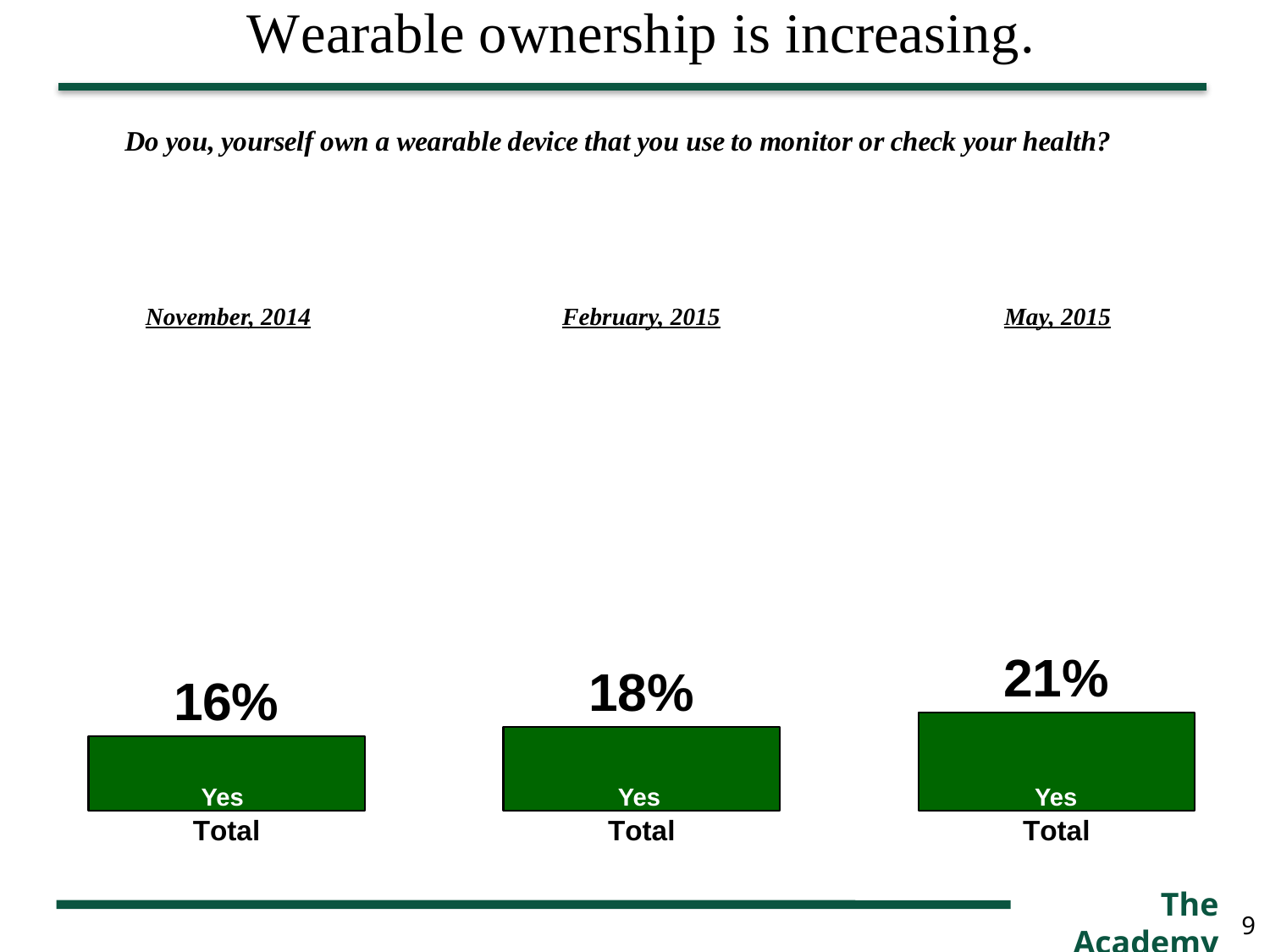
Across the three charts, which date shows the highest Yes percentage? May, 2015 What kind of chart is the November, 2014 chart? Bar chart Across the three charts, which date shows the lowest Yes percentage? November, 2014 What is the difference between the Yes percentage in the February, 2015 chart and the November, 2014 chart? 2% In the November, 2014 chart, what percentage is shown for Yes? 16% Which is larger: the Yes percentage in the February, 2015 chart or in the May, 2015 chart? May, 2015 In the February, 2015 chart, what percentage is shown for Yes? 18% What is the difference between the Yes percentage in the May, 2015 chart and the November, 2014 chart? 5% How many charts are shown on the slide? 3 Do the Yes percentages rise or fall from November, 2014 to May, 2015 across the charts? Rise What is the category label shown beneath the bar in each chart? Total In the May, 2015 chart, what percentage is shown for Yes? 21%